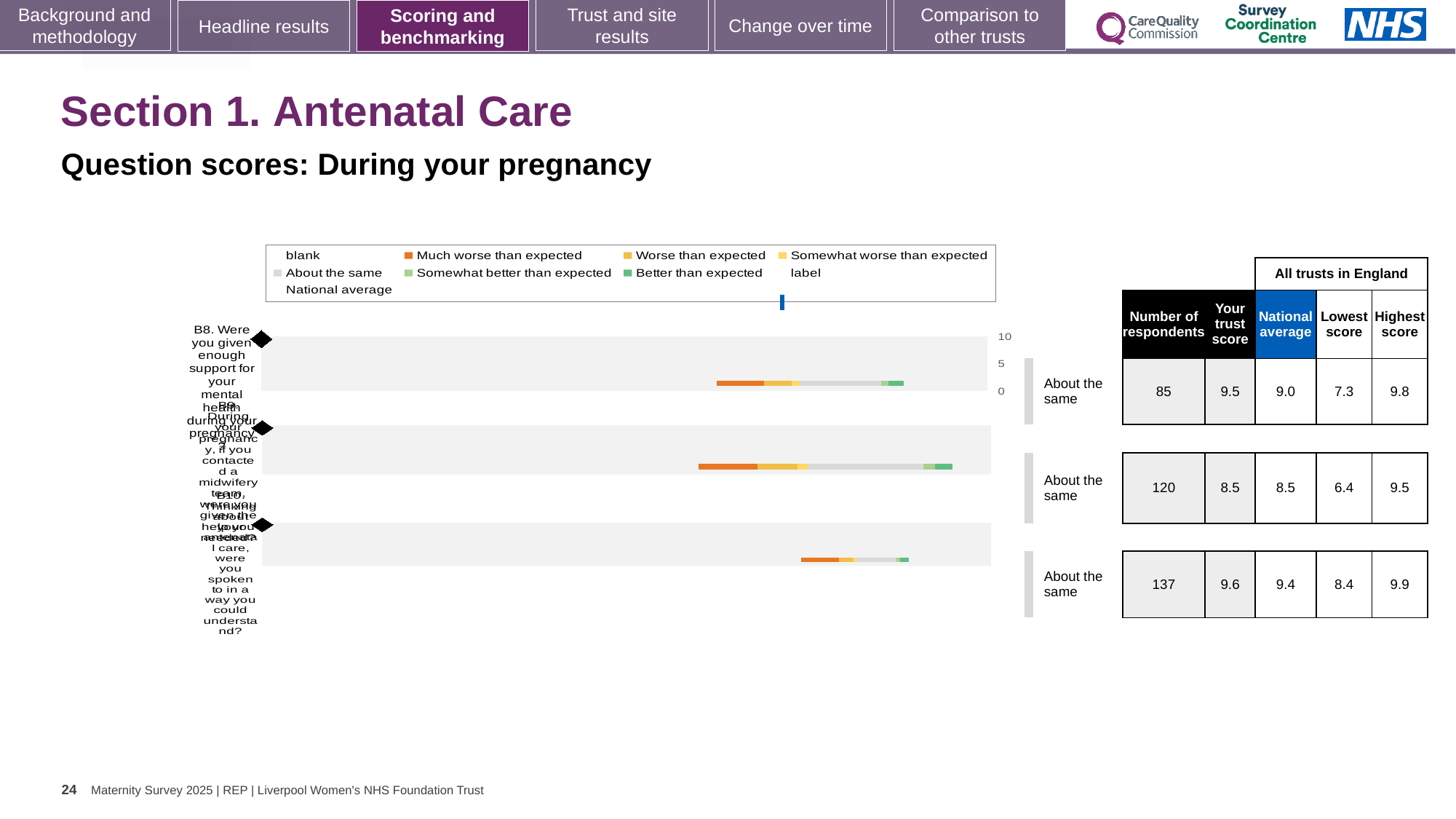
In the table beside the chart, what is 'Your trust score' for B8 (support for your mental health during pregnancy)? 9.5 How many entries does the chart legend list? 9 In the table beside the chart, what is the number of respondents for B8 (support for your mental health during pregnancy)? 85 How many question bars are plotted in the chart? 3 What benchmark category is shown next to the bar for B8 (support for your mental health during pregnancy)? About the same In the table beside the chart, which row has the highest number of respondents? the bottom row (137) What kind of chart is shown on the slide? bar chart For B8 (support for your mental health during pregnancy), which is larger: 'Your trust score' or the 'National average'? Your trust score What colour represents 'Much worse than expected' in the chart legend? orange For the middle row of the table, what is the 'National average' score? 8.5 What is the maximum value shown on the chart's score axis? 10 For the bottom row of the table, what is the difference between the highest score and the lowest score? 1.5